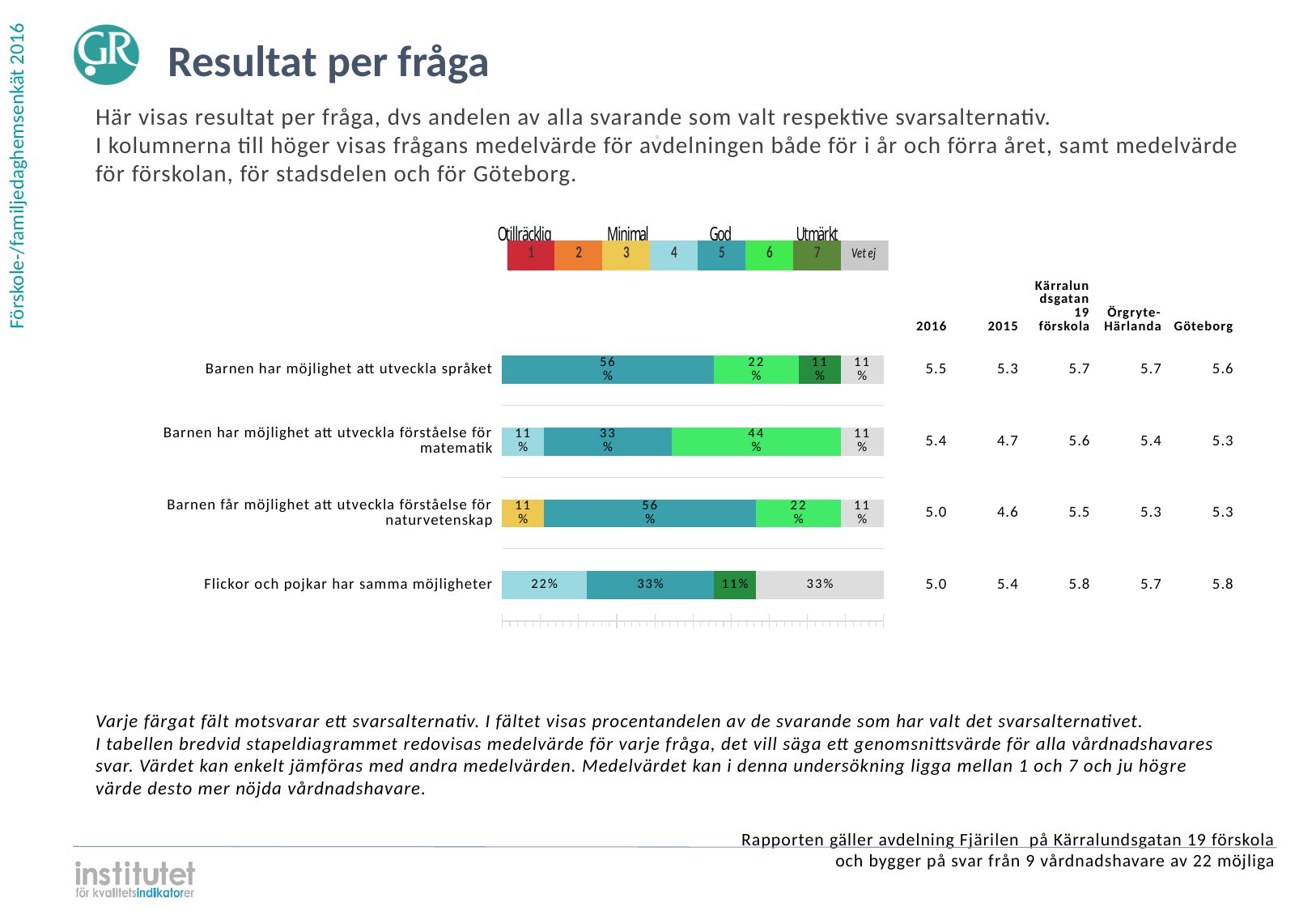
What is the 2016 mean value for 'Barnen har möjlighet att utveckla språket'? 5.5 What percentage chose answer 3 (yellow) for 'Barnen får möjlighet att utveckla förståelse för naturvetenskap'? 11% Which question has the largest 'Vet ej' share? Flickor och pojkar har samma möjligheter How many answer alternatives does the colour legend above the chart list, including 'Vet ej'? 8 What is the 'Vet ej' share for 'Flickor och pojkar har samma möjligheter'? 33% What percentage of respondents chose answer 5 (teal) for 'Barnen har möjlighet att utveckla språket'? 56% What kind of chart is used to show the results per question? Stacked bar chart What is the difference between the answer 5 share and the answer 6 share for 'Barnen får möjlighet att utveckla förståelse för naturvetenskap'? 34 percentage points Is the answer 6 share larger for 'Barnen har möjlighet att utveckla förståelse för matematik' or for 'Barnen har möjlighet att utveckla språket'? Barnen har möjlighet att utveckla förståelse för matematik How many questions (categories) are shown in the bar chart? 4 What is the 2015 mean value for 'Barnen har möjlighet att utveckla förståelse för matematik'? 4.7 What percentage chose answer 6 (bright green) for 'Barnen har möjlighet att utveckla förståelse för matematik'? 44%